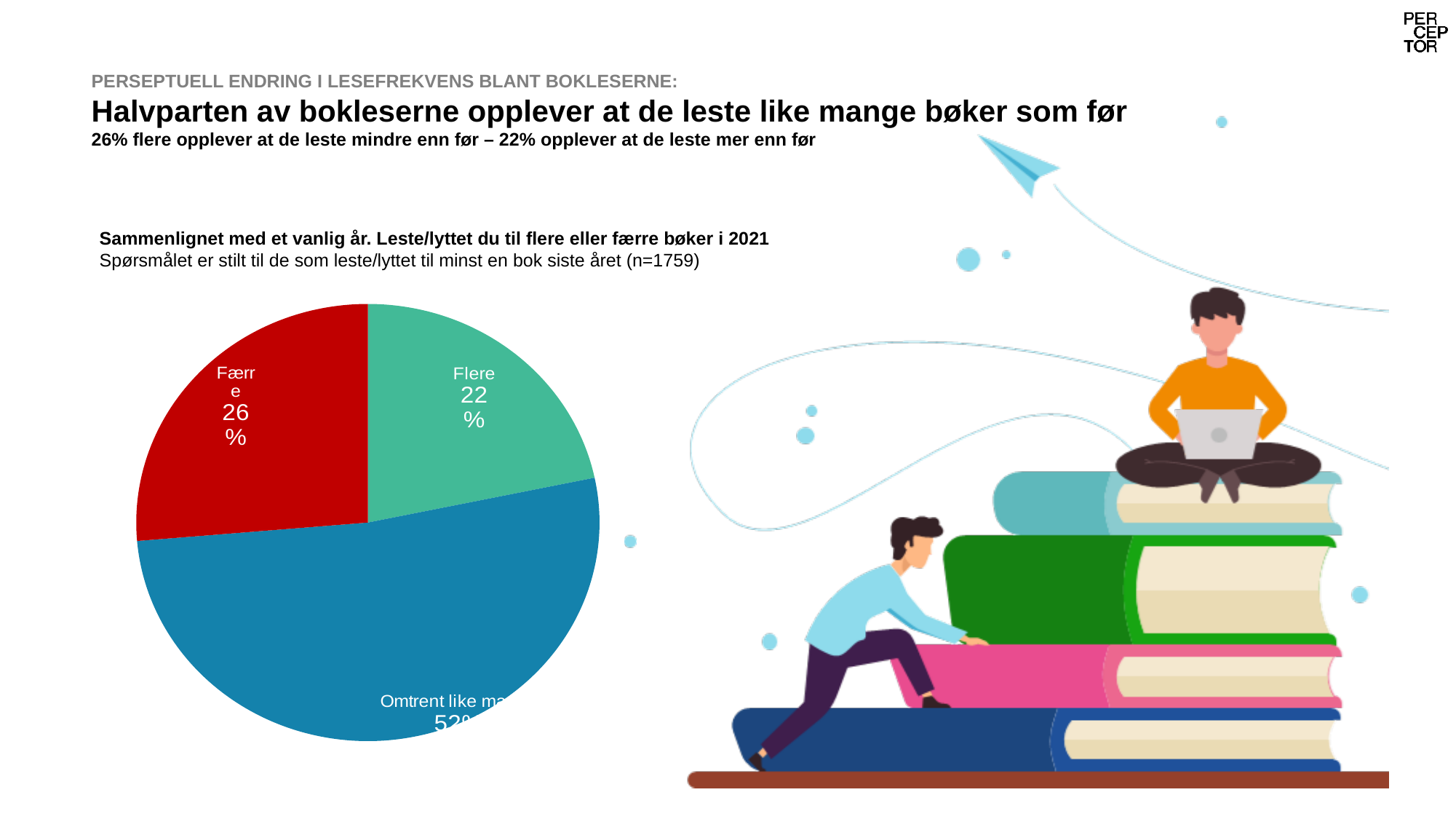
What is the difference in percentage points between the "Færre" slice and the "Flere" slice? 4% What percentage of book readers answered "Flere" in the pie chart? 22% What kind of chart is shown on the slide? pie chart Which slice of the pie chart is the smallest? Flere What percentage of book readers answered "Færre" in the pie chart? 26% Which slice is larger in the pie chart, "Færre" or "Flere"? Færre How many slices does the pie chart have? 3 Which slice of the pie chart is the largest? Omtrent like mange What is the sample size (n) stated above the pie chart? n=1759 What share of the pie does the "Flere" slice represent? 22% What share of the pie does the blue "Omtrent like mange" slice represent? 52% What colour is the "Færre" slice in the pie chart? red